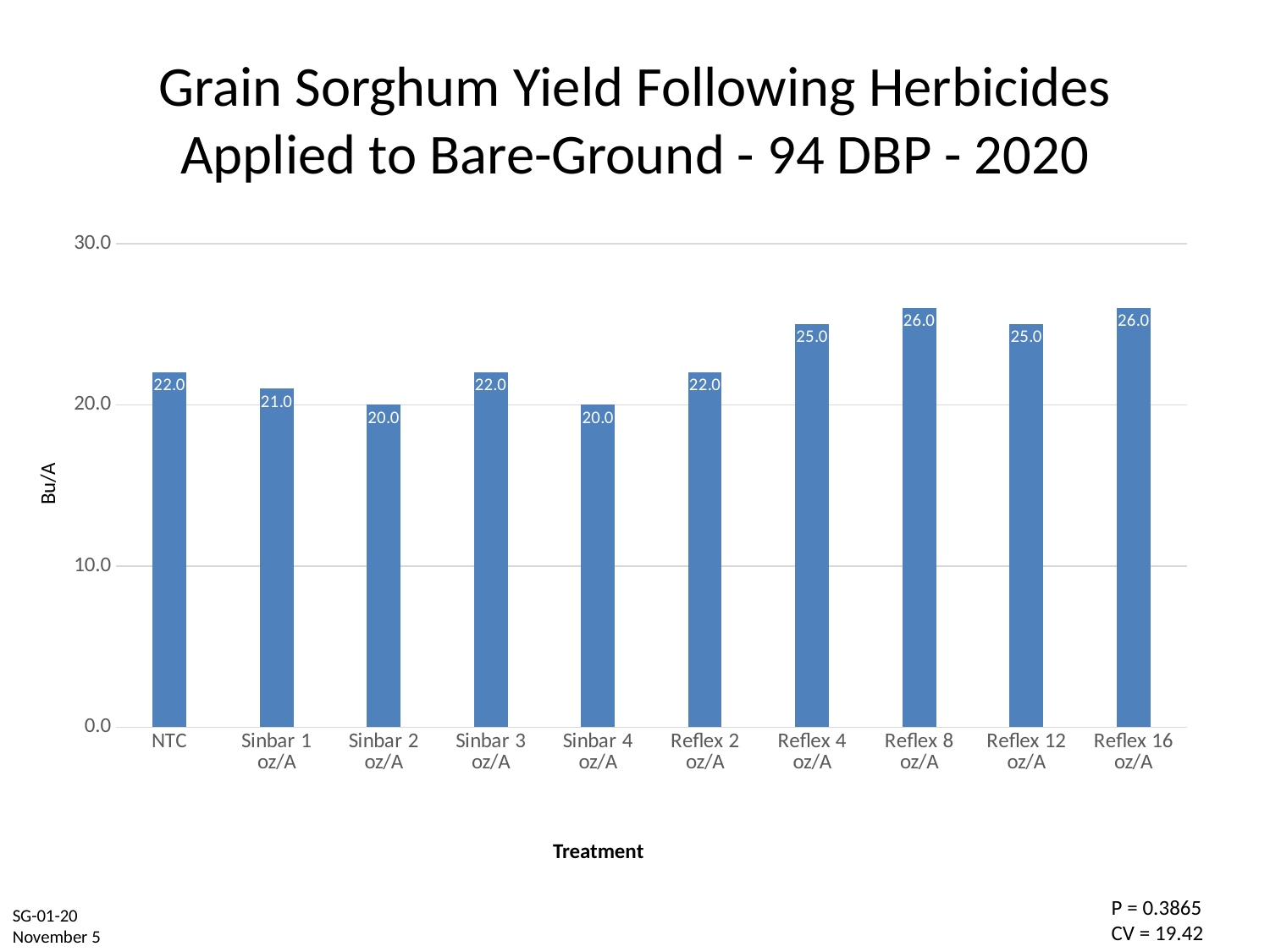
Which treatments have the highest yield? Reflex 8 oz/A and Reflex 16 oz/A What is the difference in yield between Reflex 16 oz/A and Sinbar 2 oz/A? 6.0 How many treatments are shown on the chart? 10 What is the yield for Reflex 8 oz/A? 26.0 What is the label of the x axis? Treatment Which has a higher yield, Reflex 4 oz/A or Sinbar 1 oz/A? Reflex 4 oz/A What is the yield for Sinbar 4 oz/A? 20.0 What is the yield for NTC? 22.0 What is the label of the y axis? Bu/A Which treatments have the lowest yield? Sinbar 2 oz/A and Sinbar 4 oz/A What is the yield for Reflex 12 oz/A? 25.0 What kind of chart is shown on the slide? Bar chart